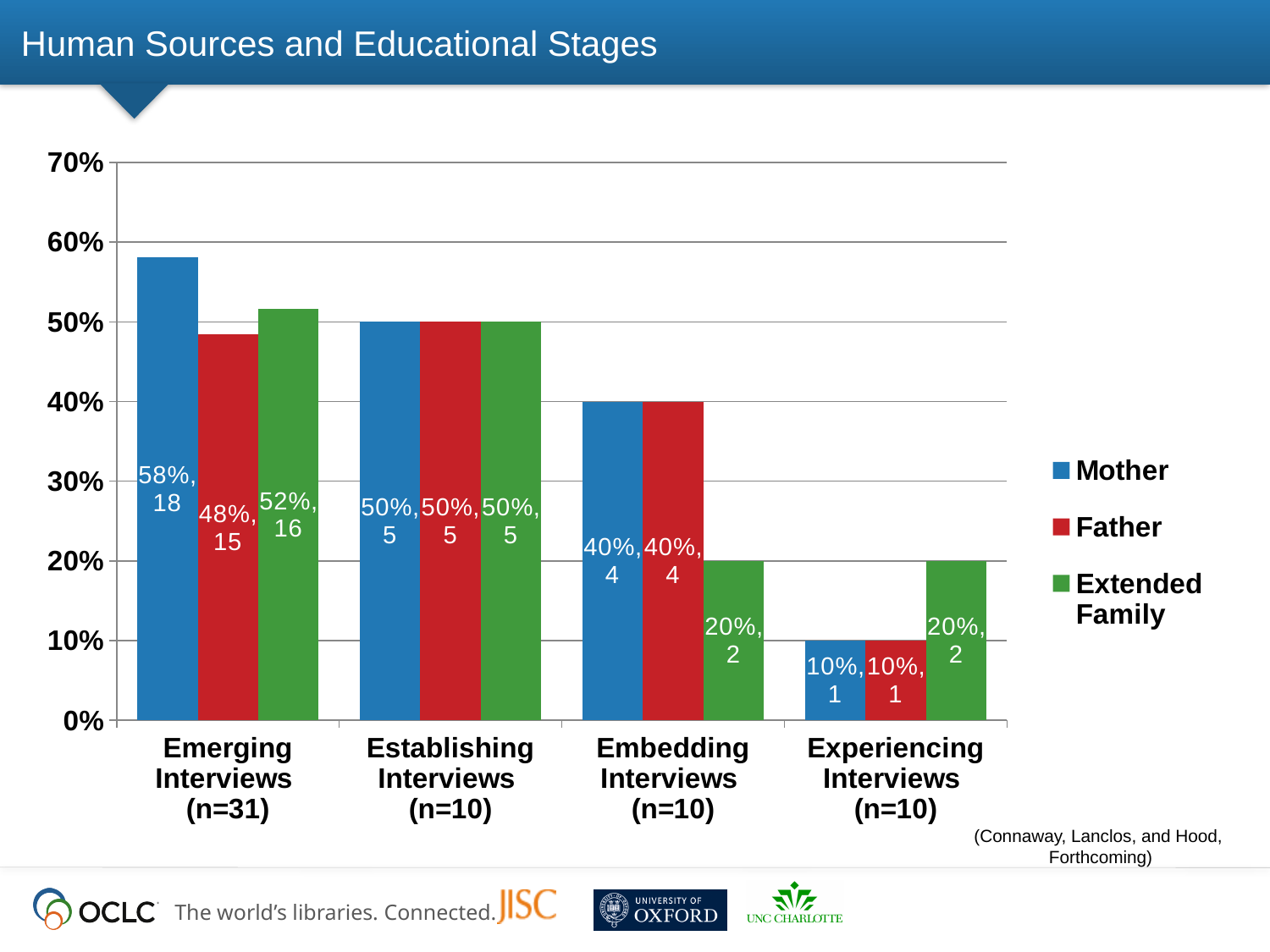
Is the value for Extended Family in the Embedding Interviews (n=10) category greater or less than 30%? less What is the difference in percentage points between Mother and Father in the Emerging Interviews (n=31) category? 10 percentage points What is the value for Extended Family in the Experiencing Interviews (n=10) category? 20%, 2 How many categories are shown on the x axis? 4 What is the value for Father in the Embedding Interviews (n=10) category? 40%, 4 What kind of chart is shown on the slide? Bar chart Which category has the lowest value for Father? Experiencing Interviews (n=10) Which category has the highest value for Mother? Emerging Interviews (n=31) What is the value for Mother in the Emerging Interviews (n=31) category? 58%, 18 Which is larger in the Emerging Interviews (n=31) category: Father or Extended Family? Extended Family Do the values for Mother rise or fall from left to right across the categories? Fall How many series does the legend list? 3